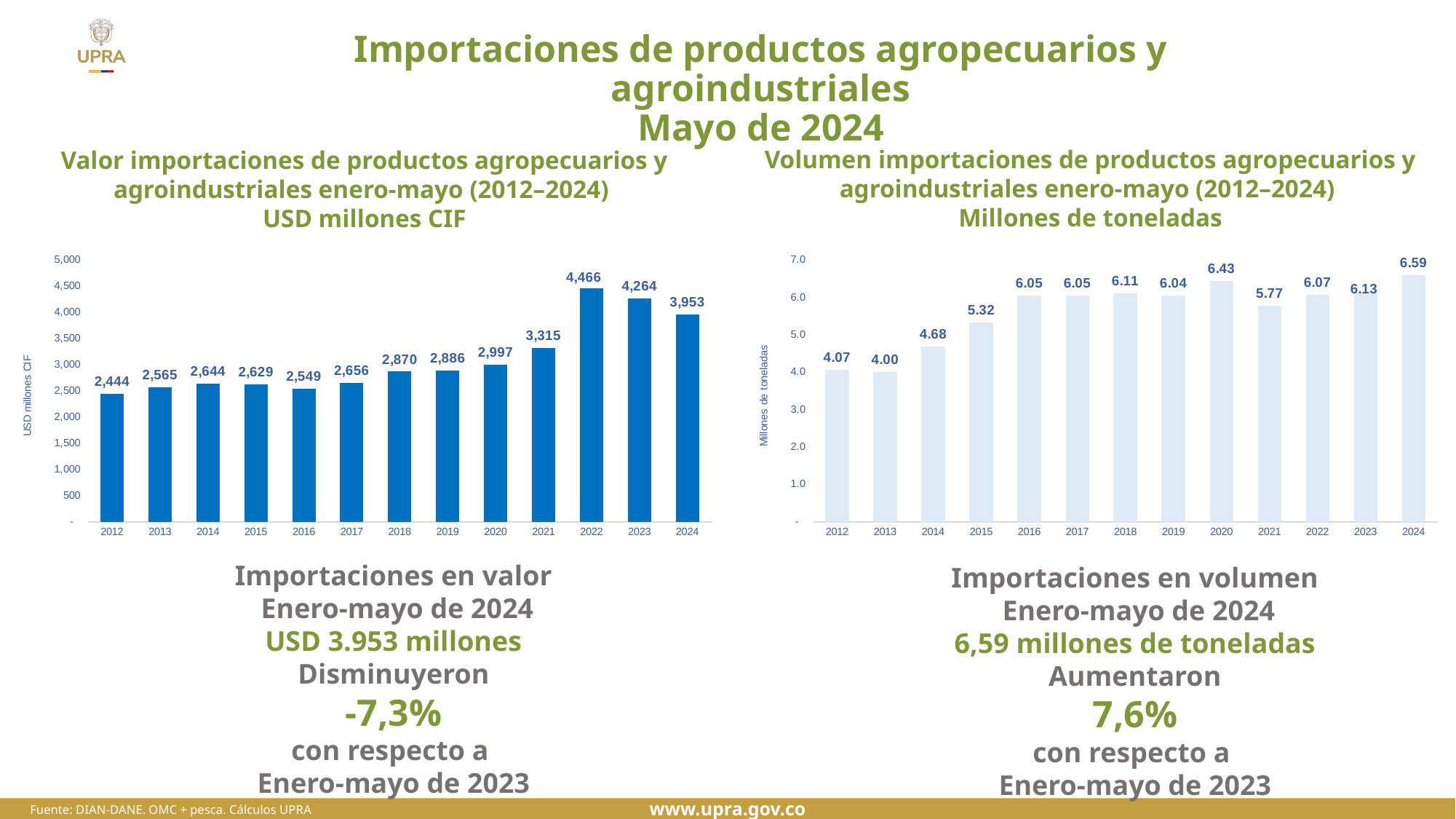
In the left chart (Valor importaciones, USD millones CIF), is the value for 2021 greater or less than 3,000? greater What type of chart is the left chart (Valor importaciones, USD millones CIF)? Bar chart In the left chart (Valor importaciones, USD millones CIF), which year has the highest value? 2022 In the left chart (Valor importaciones, USD millones CIF), what is the difference between the 2023 and 2024 values? 311 In the left chart (Valor importaciones, USD millones CIF), how many years are plotted? 13 In the right chart (Volumen importaciones, Millones de toneladas), what is the difference between the 2024 and 2023 values? 0.46 In the left chart (Valor importaciones, USD millones CIF), which year has the lowest value? 2012 In the right chart (Volumen importaciones, Millones de toneladas), which year has the lowest value? 2013 In the right chart (Volumen importaciones, Millones de toneladas), which is larger, the value for 2020 or the value for 2021? 2020 In the left chart (Valor importaciones, USD millones CIF), what is the value for 2022? 4,466 In the right chart (Volumen importaciones, Millones de toneladas), what is the value for 2015? 5.32 In the right chart (Volumen importaciones, Millones de toneladas), which year has the highest value? 2024